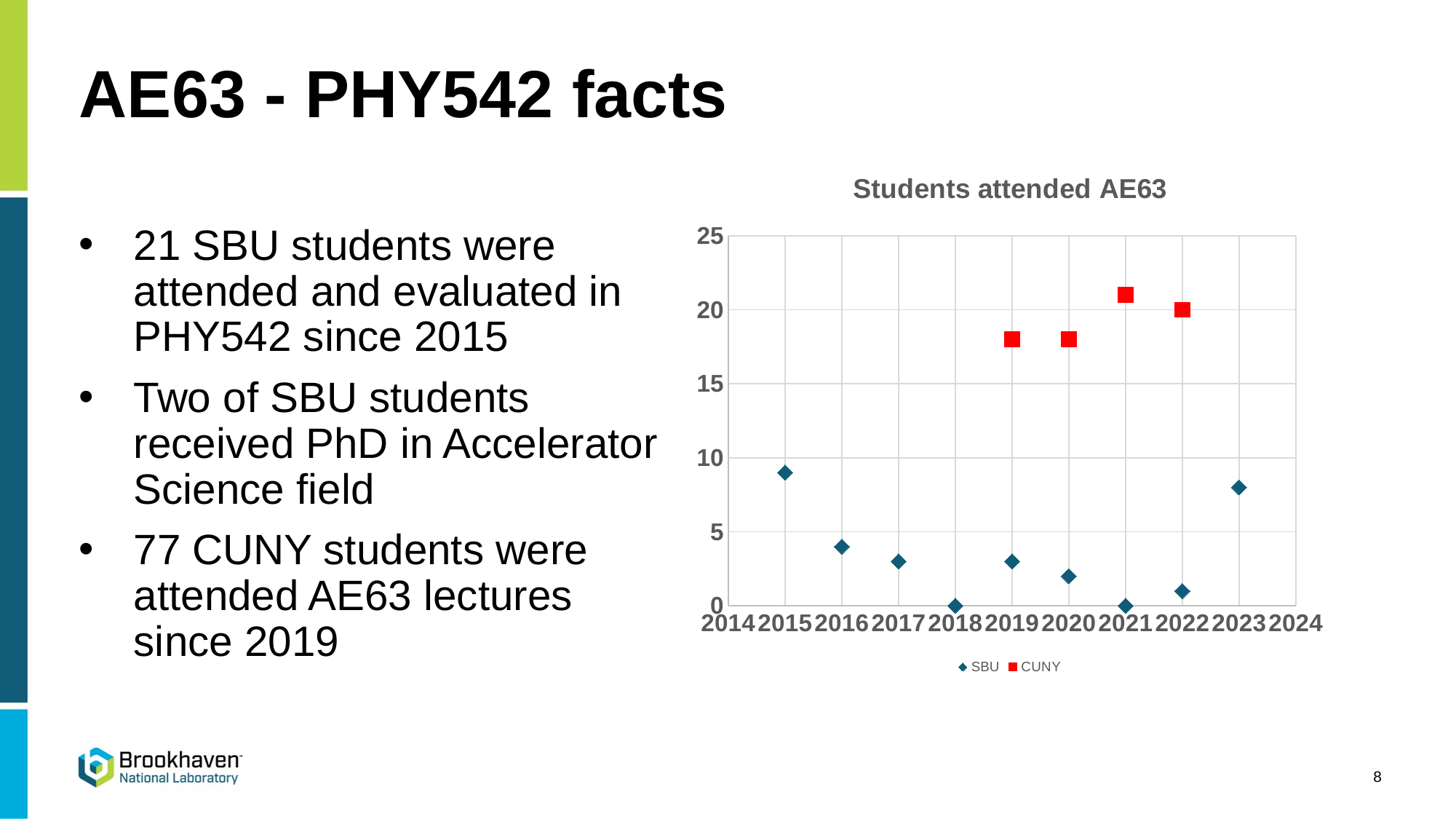
What type of chart is shown on the slide? Scatter chart Which two series are listed in the chart legend? SBU and CUNY How many data points are plotted for the CUNY series? 4 How many data points are plotted for the SBU series? 9 In 2019, which series has the larger value, SBU or CUNY? CUNY What is the SBU value for 2018? 0 Is the CUNY value for 2019 greater or less than 20? less Do the SBU values rise or fall from 2015 to 2018? Fall How many series does the chart legend list? 2 Is the SBU value for 2015 greater or less than 5? greater What is the title of the chart? Students attended AE63 What is the CUNY value for 2022? 20